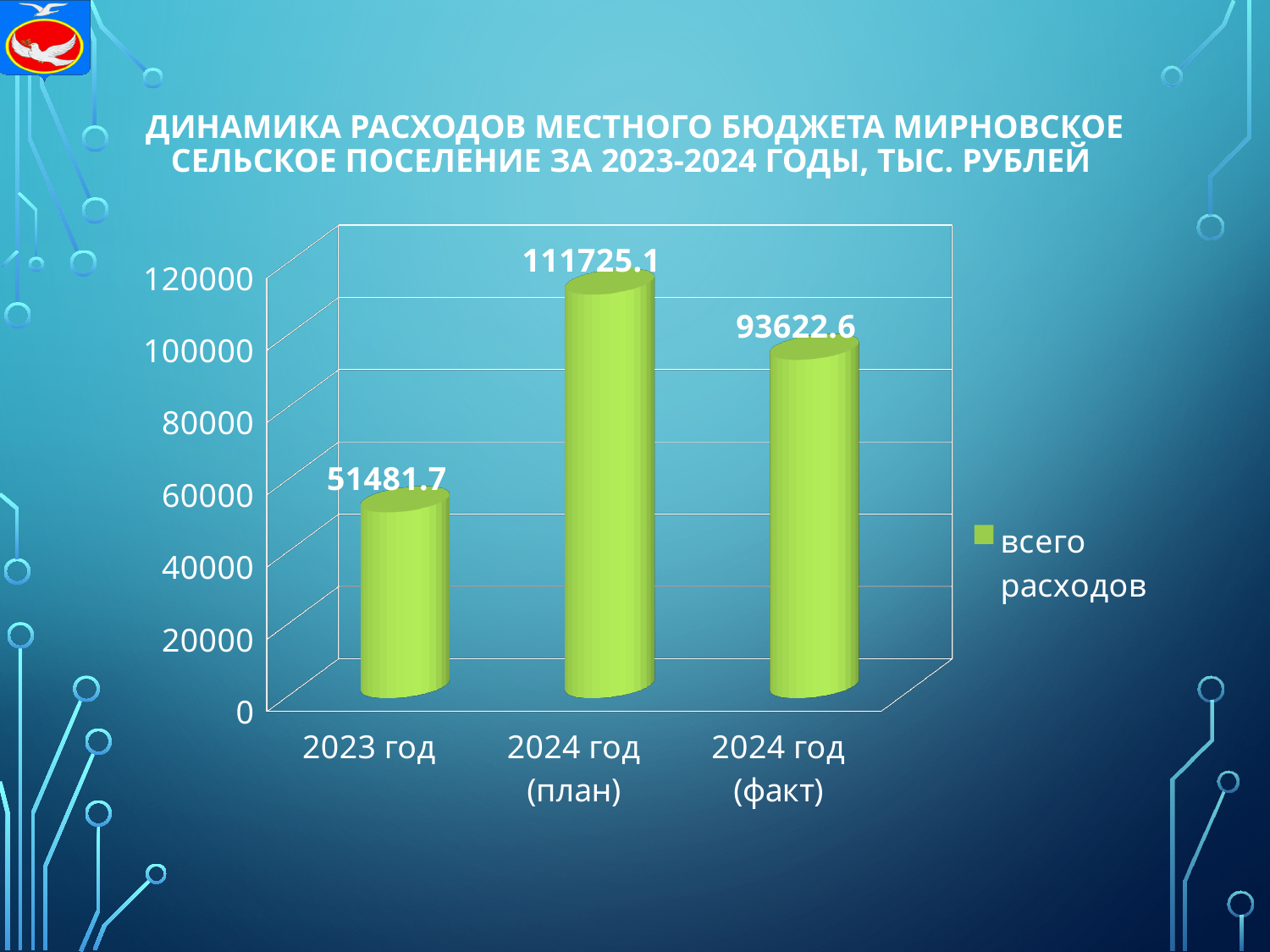
What is the value for 2024 год (план)? 111725.1 How many categories are shown on the x axis? 3 Which is larger, the value for 2024 год (факт) or the value for 2023 год? 2024 год (факт) What is the value for 2024 год (факт)? 93622.6 Which category has the highest value? 2024 год (план) Is the value for 2024 год (факт) greater or less than 80000? greater How many series does the legend list? 1 Which category has the lowest value? 2023 год What kind of chart is shown on the slide? bar chart What is the difference between the values for 2024 год (план) and 2024 год (факт)? 18102.5 What is the difference between the values for 2024 год (факт) and 2023 год? 42140.9 What is the value for 2023 год? 51481.7